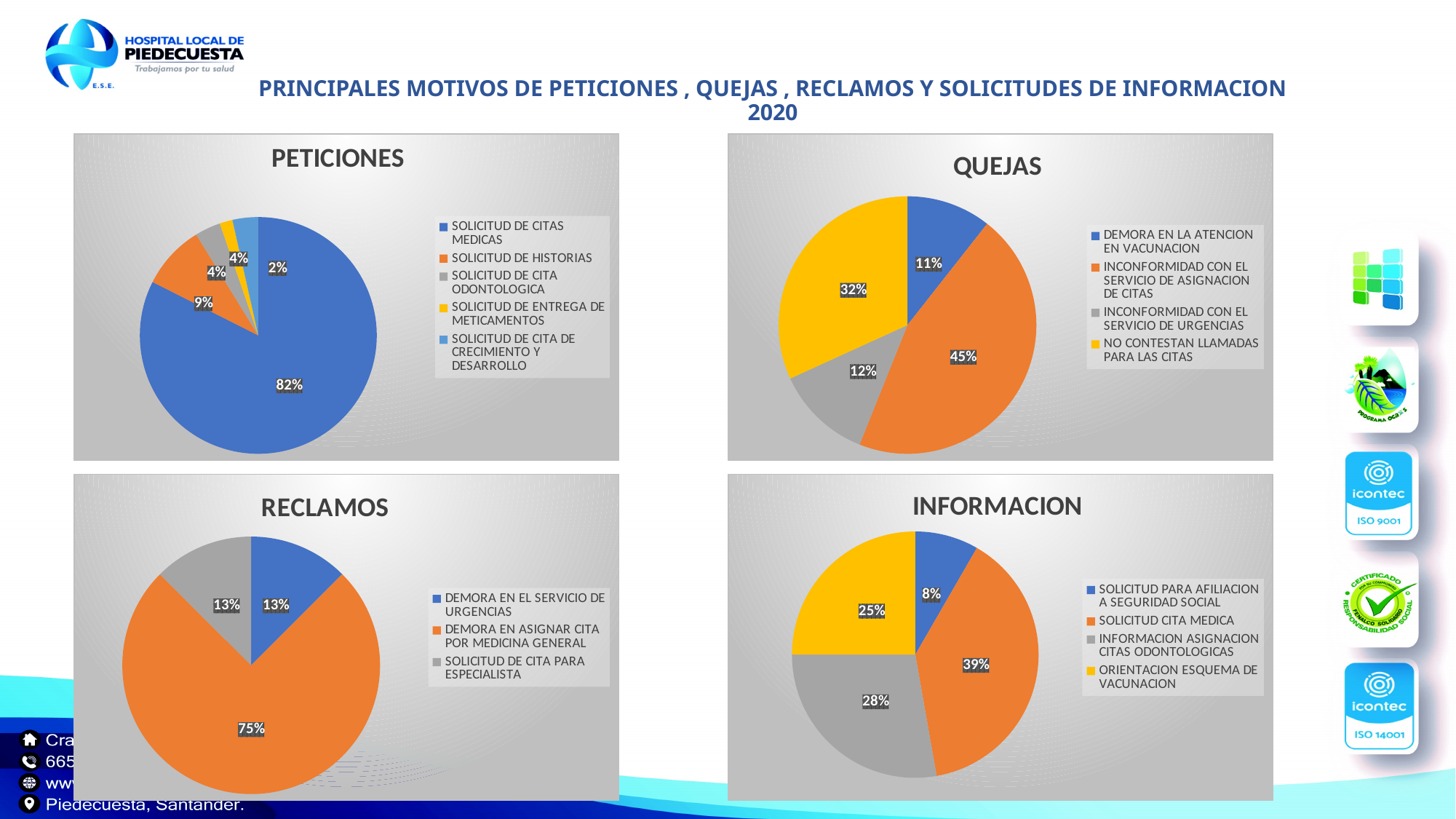
In the PETICIONES chart, what is the value for SOLICITUD DE HISTORIAS? 9% In the RECLAMOS chart, how many categories are shown? 3 In the PETICIONES chart, what share does SOLICITUD DE CITAS MEDICAS have? 82% In the INFORMACION chart, which is larger: SOLICITUD CITA MEDICA or INFORMACION ASIGNACION CITAS ODONTOLOGICAS? SOLICITUD CITA MEDICA In the QUEJAS chart, what is the difference between INCONFORMIDAD CON EL SERVICIO DE ASIGNACION DE CITAS and DEMORA EN LA ATENCION EN VACUNACION? 34% In the QUEJAS chart, what is the value for NO CONTESTAN LLAMADAS PARA LAS CITAS? 32% In the PETICIONES chart, how many categories does the legend list? 5 In the INFORMACION chart, what is the value for ORIENTACION ESQUEMA DE VACUNACION? 25% In the QUEJAS chart, which category has the smallest slice? DEMORA EN LA ATENCION EN VACUNACION What type of chart is the INFORMACION chart? Pie chart In the QUEJAS chart, which category has the largest slice? INCONFORMIDAD CON EL SERVICIO DE ASIGNACION DE CITAS In the RECLAMOS chart, what is the value for DEMORA EN ASIGNAR CITA POR MEDICINA GENERAL? 75%